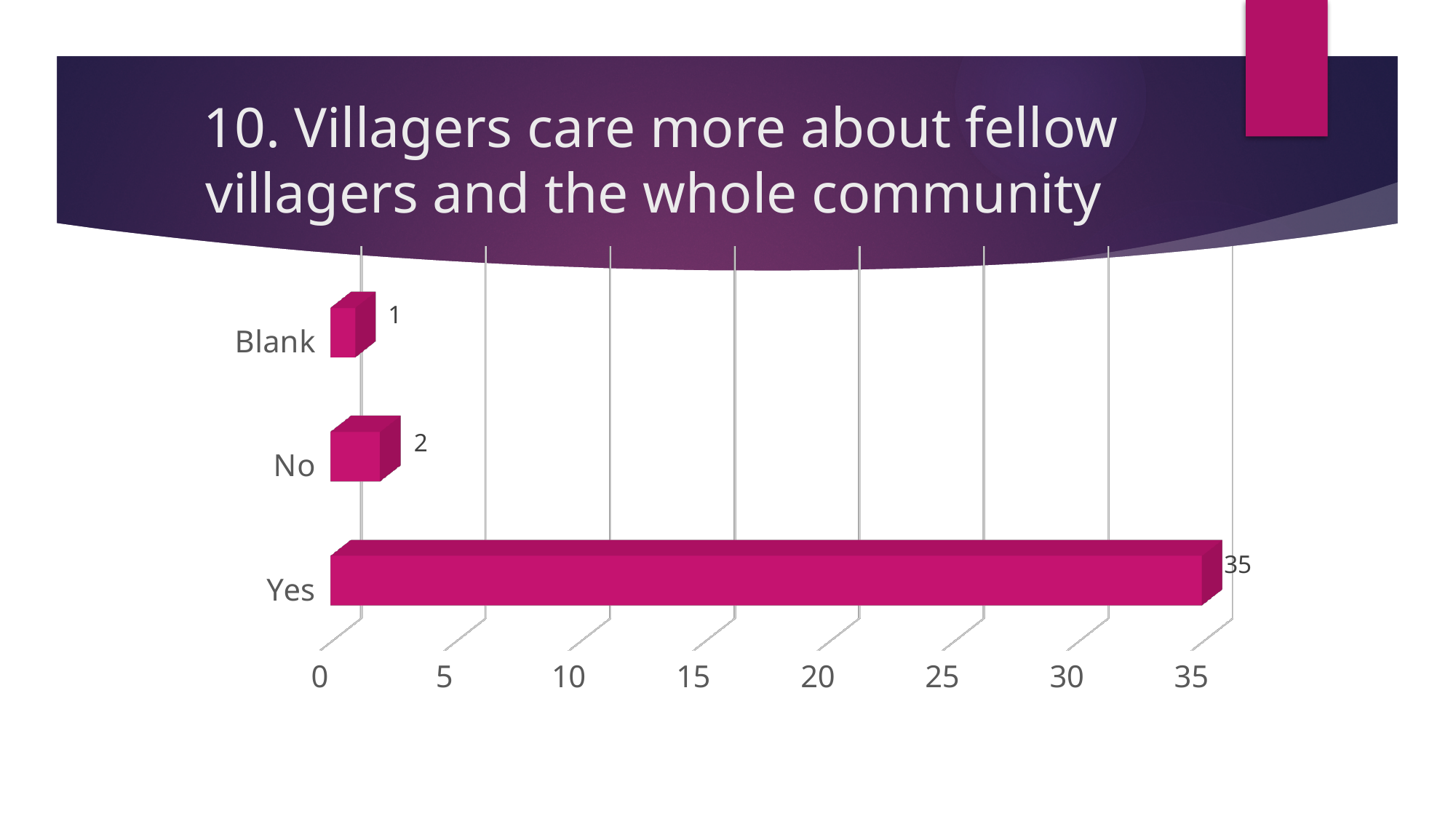
What is the value for Yes? 35 What kind of chart is shown on the slide? bar chart Which category has the lowest value? Blank What is the value for Blank? 1 What is the value for No? 2 What is the difference between the values for No and Blank? 1 What is the difference between the values for Yes and No? 33 Is the value for Yes greater or less than 30? greater Which is larger, the value for No or the value for Blank? No How many categories are shown in the chart? 3 What is the title of the slide? 10. Villagers care more about fellow villagers and the whole community Which category has the highest value? Yes